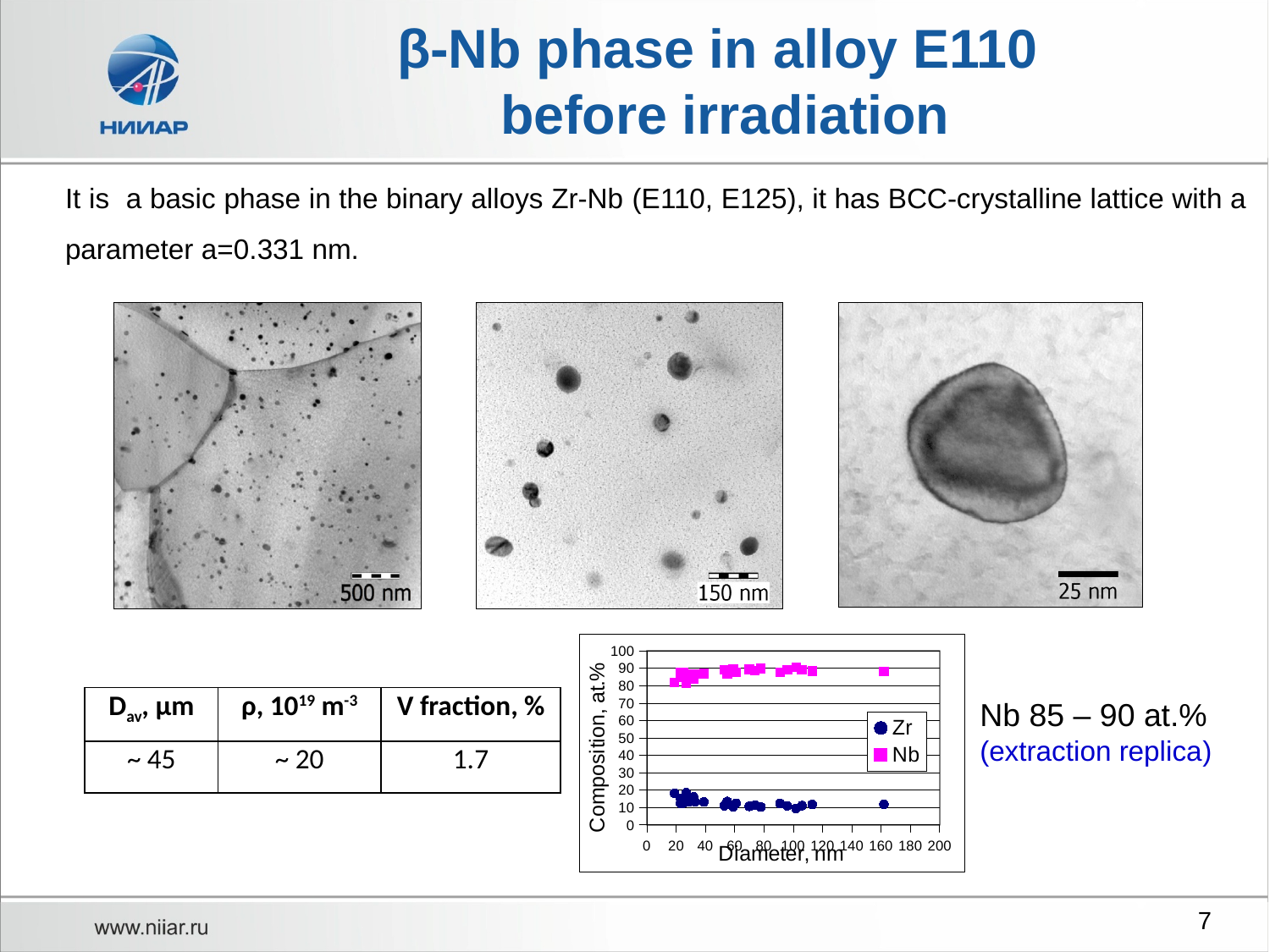
Is the Zr composition at a diameter of about 160 nm greater or less than 40? less Does the Nb composition rise sharply, fall sharply, or stay roughly constant as diameter increases from 20 to 160 nm? stays roughly constant What kind of chart is shown on the slide? scatter chart Is the Nb composition at a diameter of about 160 nm greater or less than 70? greater Which two series are listed in the chart's legend? Zr and Nb Which series is plotted with magenta square markers? Nb Are the Zr composition values greater or less than 30 at.%? less How many series does the chart's legend list? 2 What is the label of the chart's vertical axis? Composition, at.% Which series has the higher composition values across all diameters, Zr or Nb? Nb